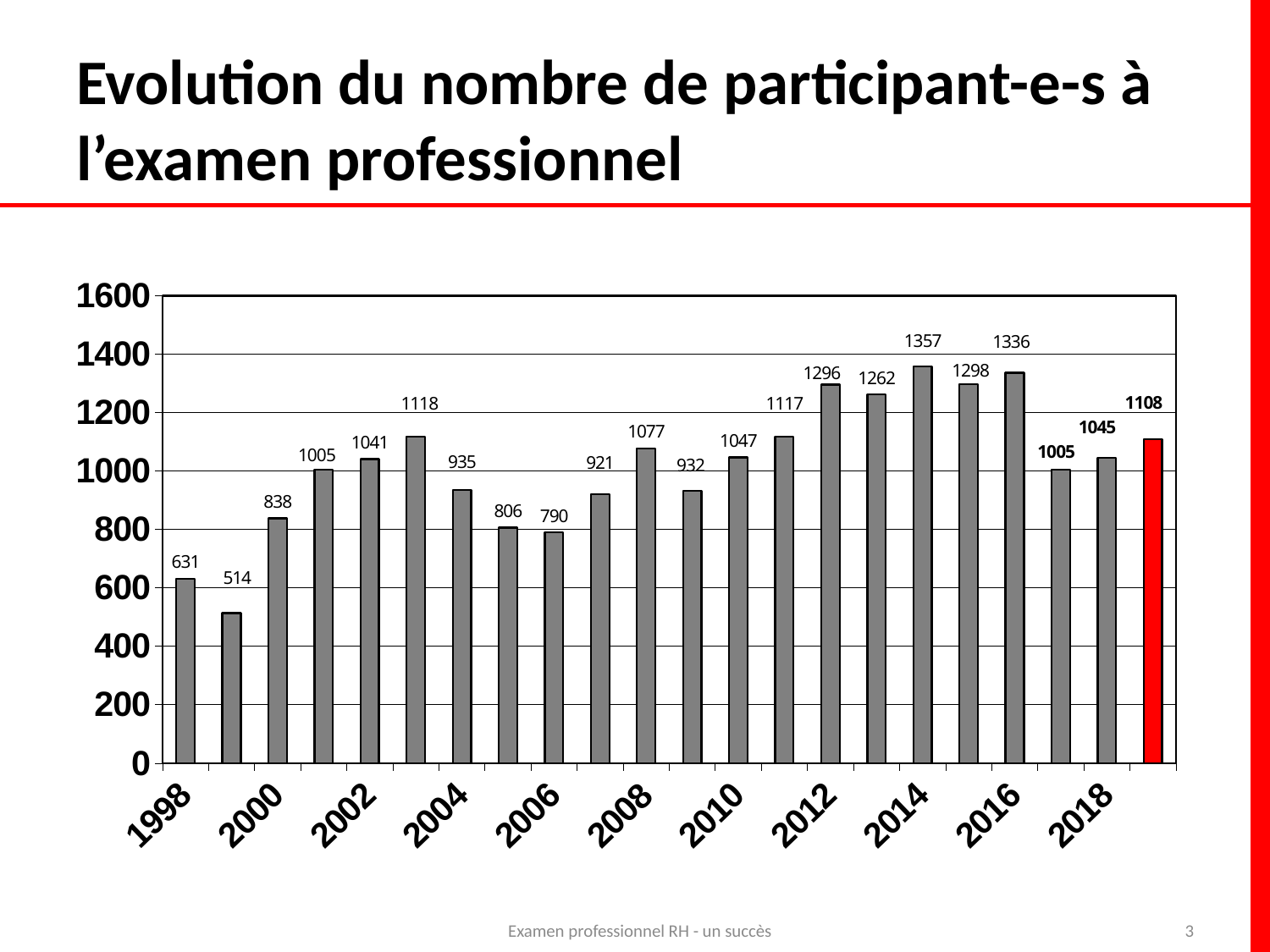
What is the number of participants in 2006? 790 Which year has more participants, 2000 or 2010? 2010 How many bars are shown on the chart? 22 What is the number of participants in 2014? 1357 What is the number of participants in 1998? 631 What is the difference between the values for 2016 and 2018? 291 Which year has the highest number of participants? 2014 What is the lowest value shown on the chart? 514 What value is shown for the red bar at the far right of the chart? 1108 What colour is the last bar on the chart? red Is the value for 2012 greater or less than 1200? greater What type of chart is shown on the slide? bar chart